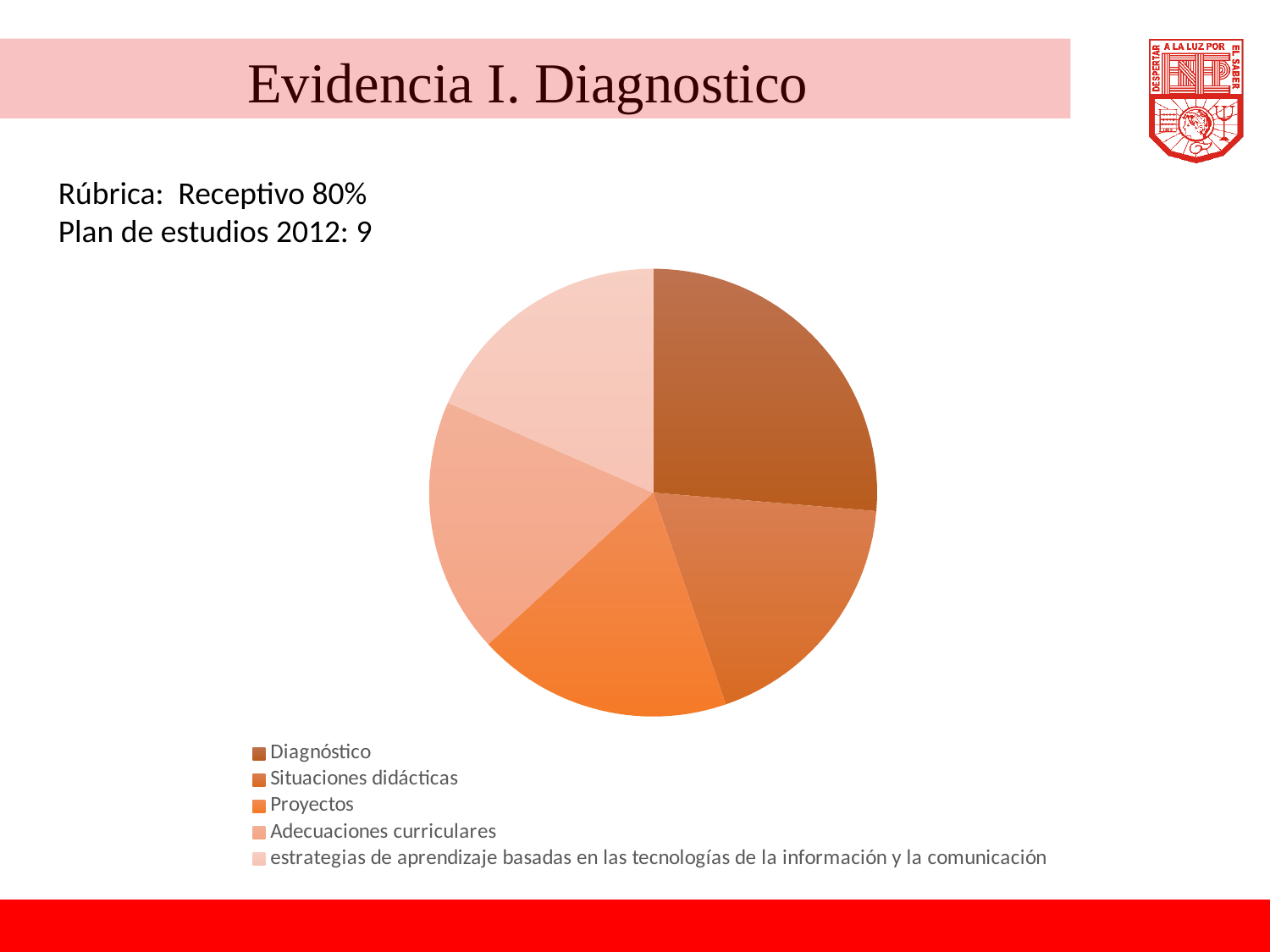
How many entries does the legend of the pie chart list? 5 What kind of chart is shown on the slide? pie chart How many slices does the pie chart have? 5 Which slice is larger, Diagnóstico or Adecuaciones curriculares? Diagnóstico What is the title of the slide containing the pie chart? Evidencia I. Diagnostico Which legend entry is listed last in the pie chart's legend? estrategias de aprendizaje basadas en las tecnologías de la información y la comunicación Which slice is larger, Diagnóstico or Proyectos? Diagnóstico Which category has the largest slice in the pie chart? Diagnóstico Which slice is larger, Diagnóstico or Situaciones didácticas? Diagnóstico